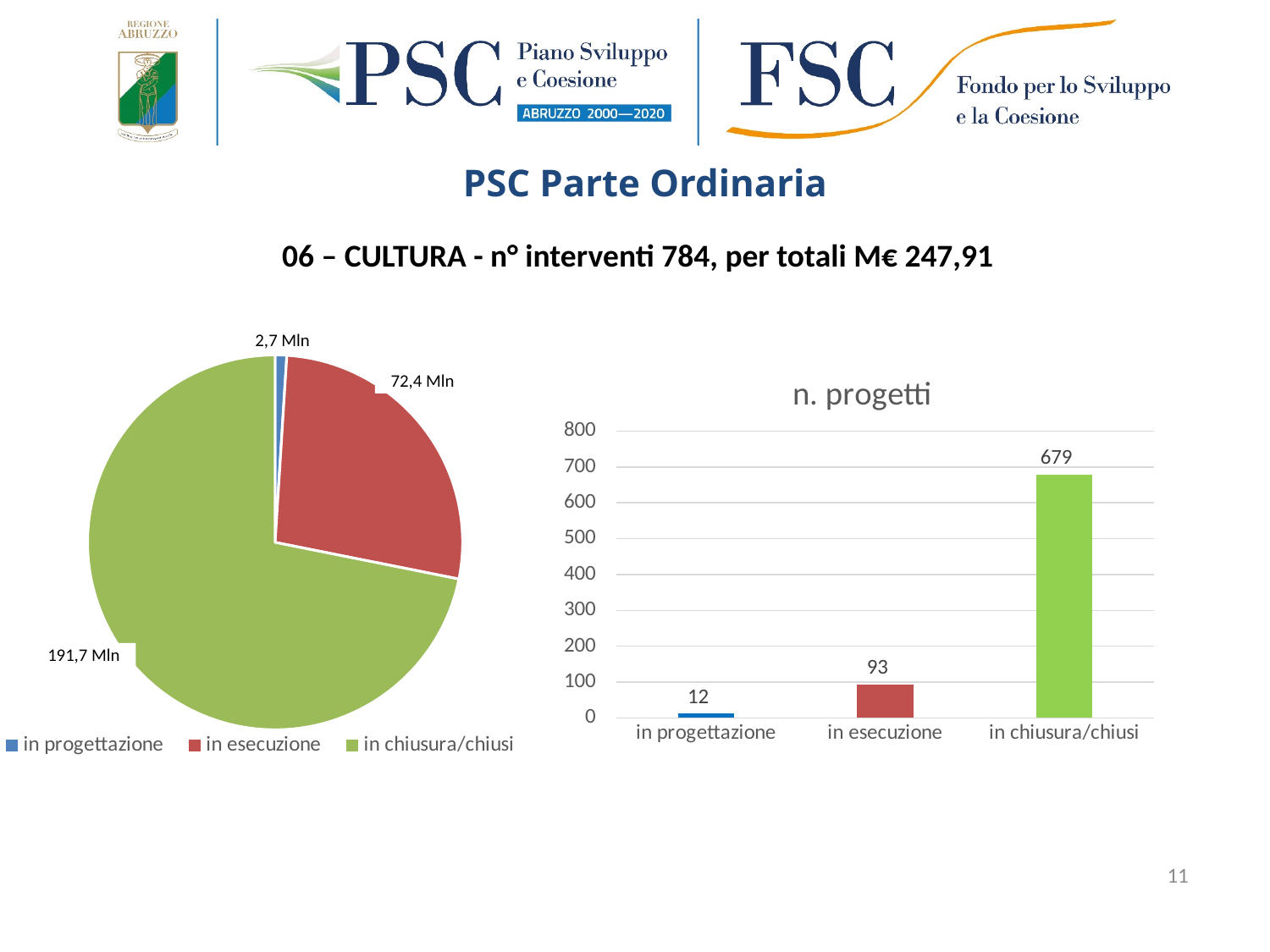
In the pie chart on the left, is the value for "in esecuzione" larger or smaller than the value for "in chiusura/chiusi"? smaller In the bar chart titled "n. progetti", what is the difference between the values for "in chiusura/chiusi" and "in esecuzione"? 586 In the bar chart titled "n. progetti", how many categories are shown on the x axis? 3 In the bar chart titled "n. progetti", which category has the highest value? in chiusura/chiusi In the bar chart titled "n. progetti", what is the value for "in esecuzione"? 93 In the bar chart titled "n. progetti", what is the value for "in progettazione"? 12 In the pie chart on the left, what is the value labelled for the "in chiusura/chiusi" slice? 191,7 Mln In the bar chart titled "n. progetti", which category has the lowest value? in progettazione In the pie chart on the left, which slice is the smallest? in progettazione In the pie chart on the left, what is the value labelled for the "in esecuzione" slice? 72,4 Mln In the bar chart titled "n. progetti", what is the value for "in chiusura/chiusi"? 679 What kind of chart is the chart on the right of the slide? bar chart